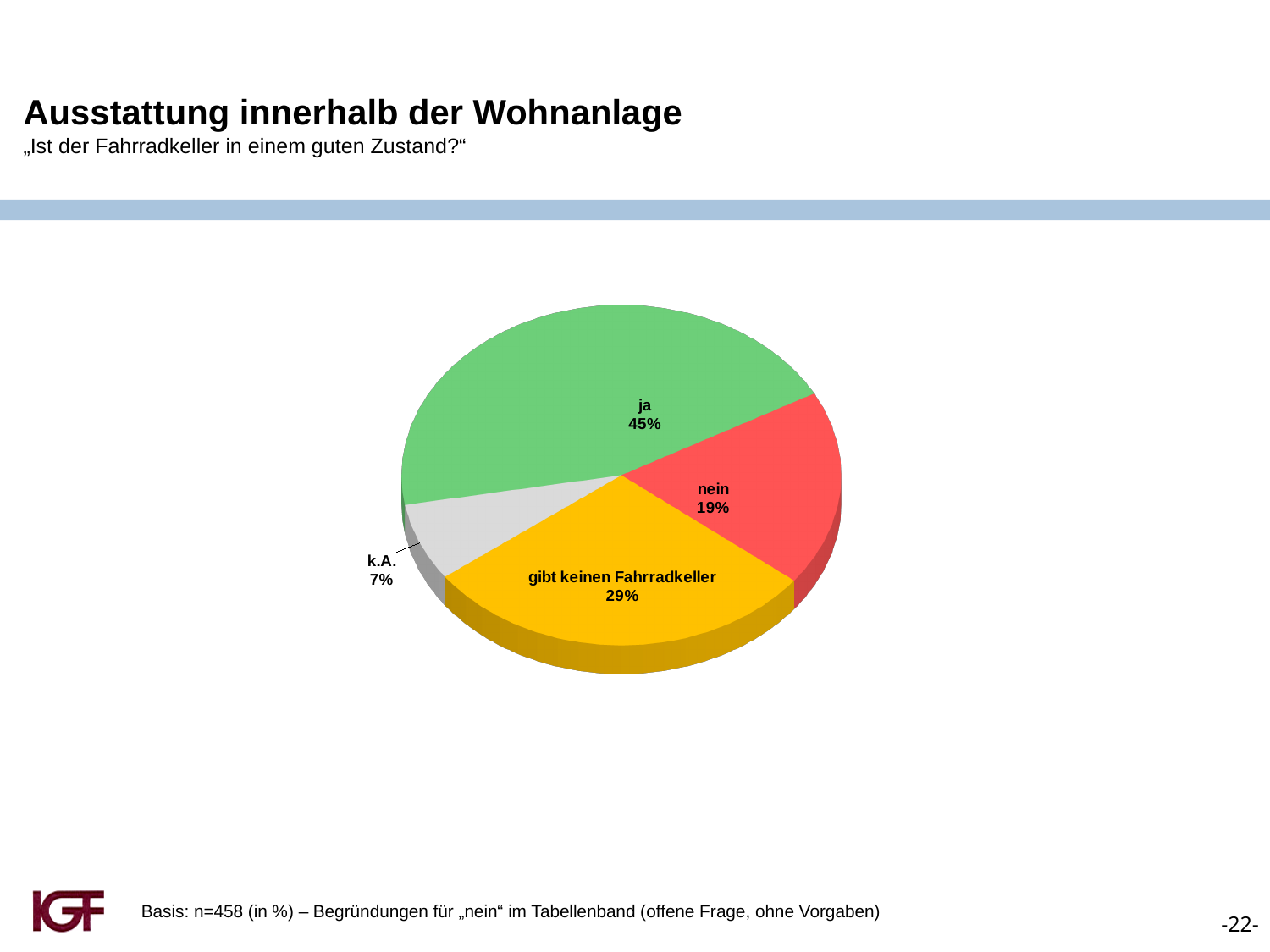
Which category has the smallest slice of the pie? k.A. What percentage of respondents answered "ja"? 45% What colour is the "ja" slice? green What is the difference in percentage points between "ja" and "nein"? 26 What is the share for "k.A."? 7% What is the share for "gibt keinen Fahrradkeller"? 29% What percentage of respondents answered "nein"? 19% What is the sample size (n) stated at the bottom of the slide? n=458 Which category has the largest slice of the pie? ja How many slices does the pie chart have? 4 Which is larger, the share for "nein" or the share for "gibt keinen Fahrradkeller"? gibt keinen Fahrradkeller What kind of chart is shown on the slide? pie chart